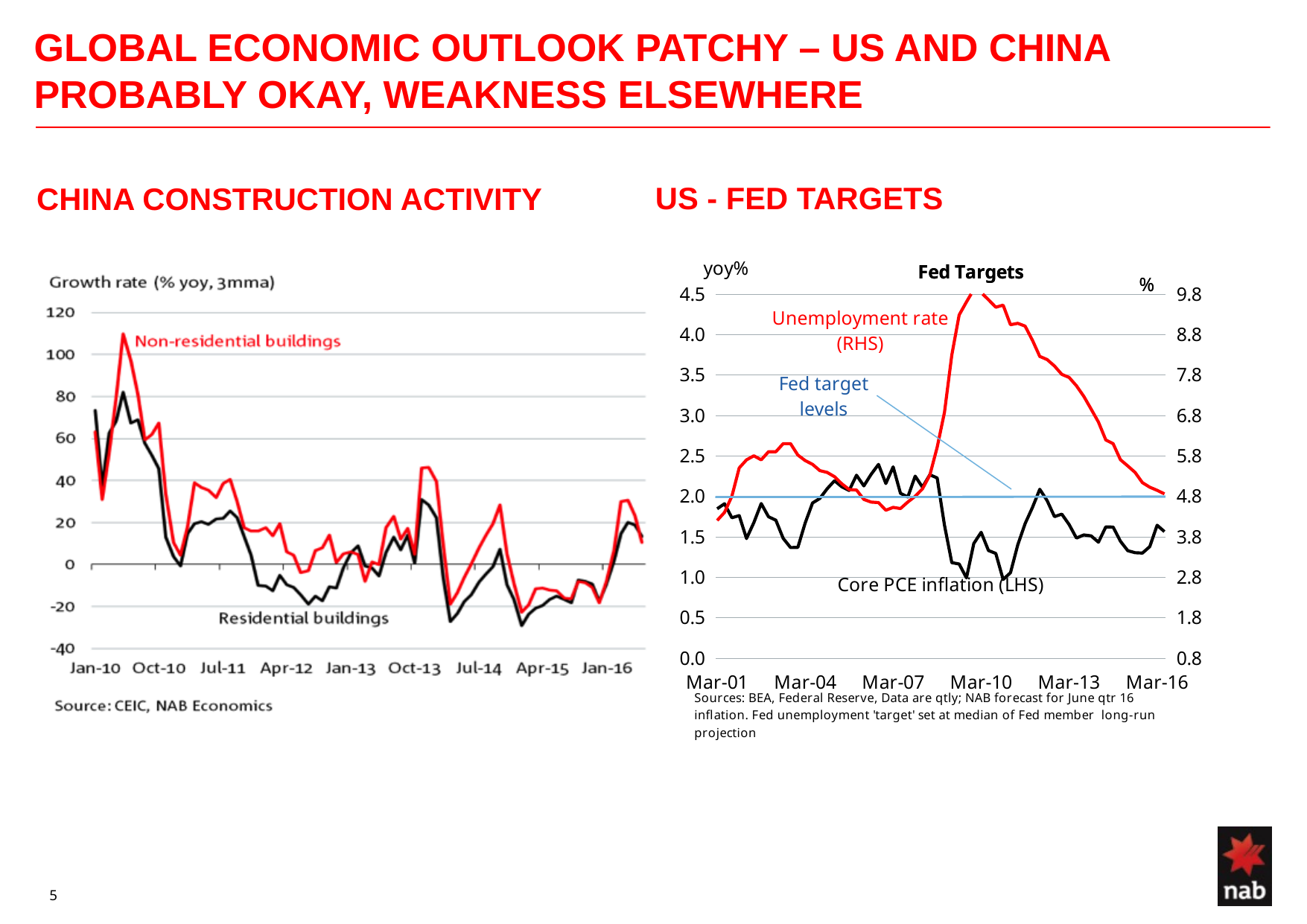
On the Fed Targets chart, which series is plotted on the right-hand axis? Unemployment rate On the China Construction Activity chart, is the peak value for Non-residential buildings greater or less than 100? greater On the Fed Targets chart, does the Unemployment rate rise or fall between Mar-10 and Mar-16? fall What kind of chart is the China Construction Activity chart? line chart On the China Construction Activity chart, is the peak value for Residential buildings greater or less than 60? greater On the Fed Targets chart, is the peak of the Unemployment rate greater or less than 8.8? greater What kind of chart is the Fed Targets chart? line chart On the China Construction Activity chart, which series reaches the higher peak? Non-residential buildings How many series are plotted on the China Construction Activity chart? 2 On the Fed Targets chart, at what level on the left axis is the Fed target line drawn? 2.0